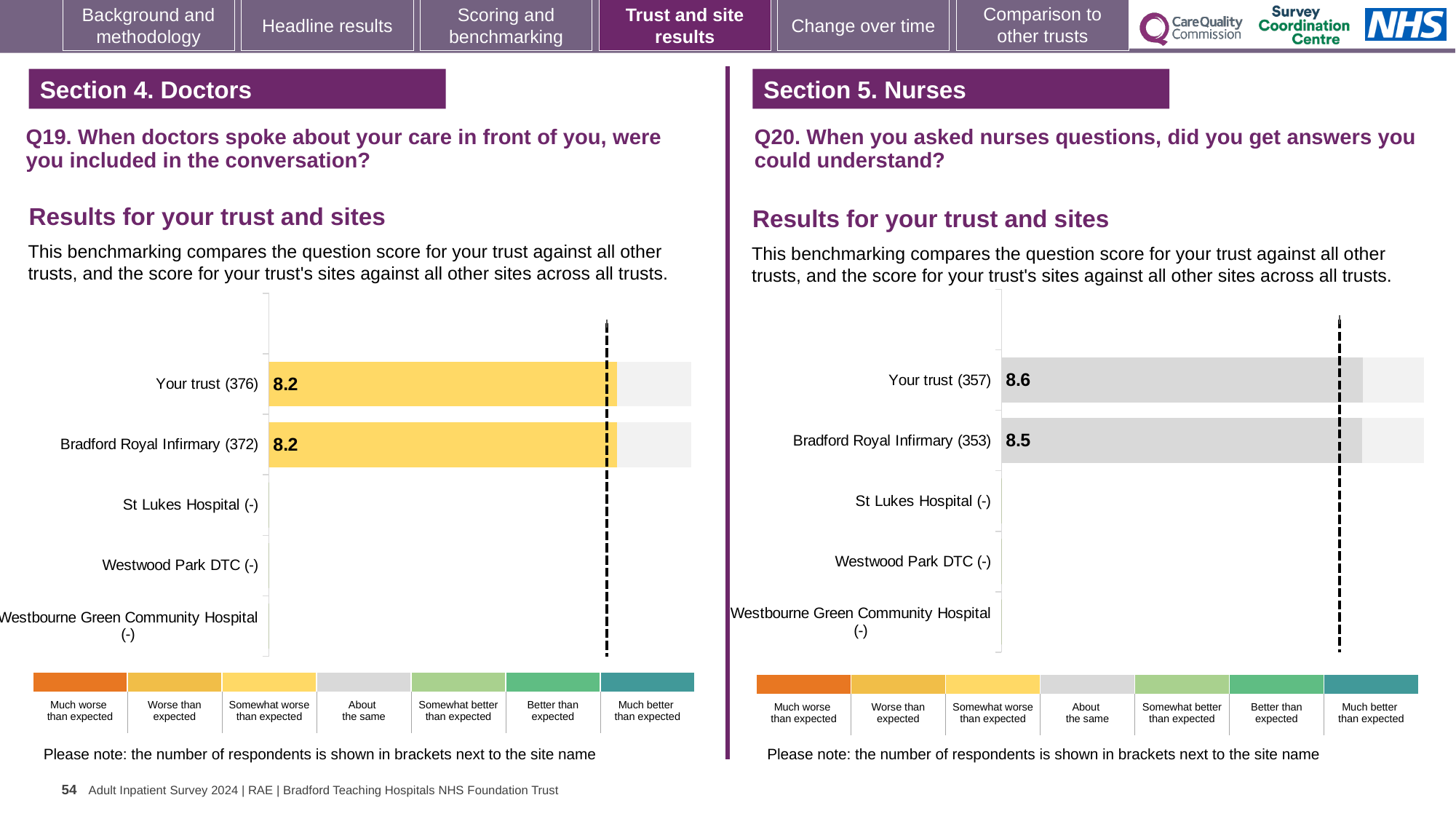
What kind of chart is used for the Q20 results (Section 5. Nurses)? Bar chart On the Q19 chart (Section 4. Doctors), what is the score for Bradford Royal Infirmary? 8.2 How many site/trust categories are listed on the Q19 chart (Section 4. Doctors)? 5 On the Q19 chart (Section 4. Doctors), what is the score for Your trust? 8.2 On the Q19 chart (Section 4. Doctors), which benchmark category does the colour of the Your trust bar correspond to in the legend? Somewhat worse than expected On the Q20 chart (Section 5. Nurses), how many respondents are shown in brackets for Bradford Royal Infirmary? 353 On the Q20 chart (Section 5. Nurses), what is the difference between the score for Your trust and the score for Bradford Royal Infirmary? 0.1 On the Q20 chart (Section 5. Nurses), what is the score for Bradford Royal Infirmary? 8.5 On the Q20 chart (Section 5. Nurses), which benchmark category does the colour of the Your trust bar correspond to in the legend? About the same On the Q19 chart (Section 4. Doctors), how many respondents are shown in brackets for Your trust? 376 On the Q20 chart (Section 5. Nurses), which has the higher score: Your trust or Bradford Royal Infirmary? Your trust On the Q20 chart (Section 5. Nurses), what is the score for Your trust? 8.6